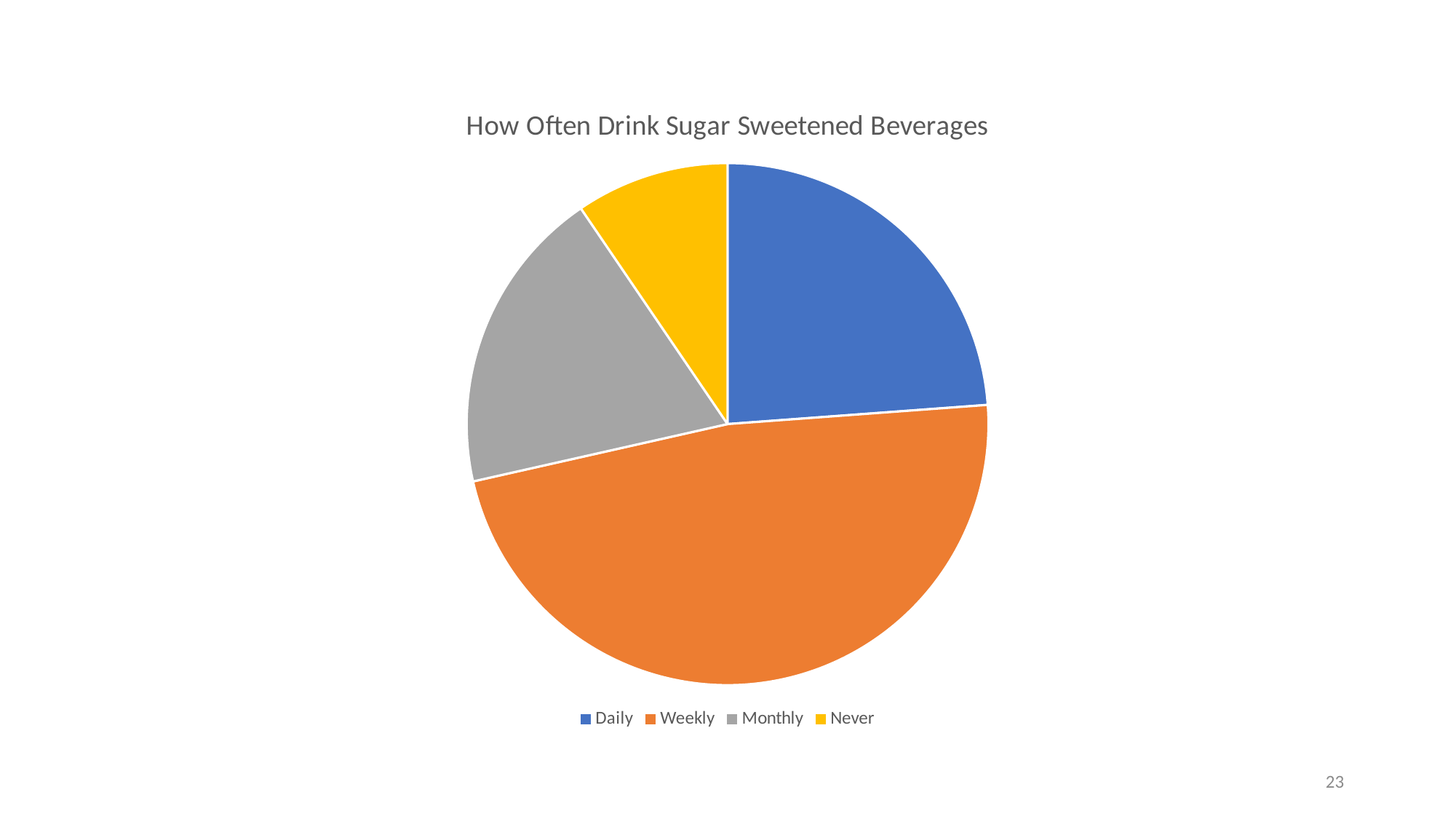
Which category is shown in grey? Monthly Which category has the smallest slice of the pie? Never Does the Weekly slice account for more or less than half of the pie? less Which category has the largest slice of the pie? Weekly Which slice is larger, Monthly or Never? Monthly What kind of chart is shown on the slide? pie chart Which slice is larger, Daily or Monthly? Daily How many entries does the legend list? 4 Which colour represents the Never category in the legend? yellow Which slice is larger, Weekly or Daily? Weekly How many categories does the pie chart have? 4 What is the title of the chart? How Often Drink Sugar Sweetened Beverages